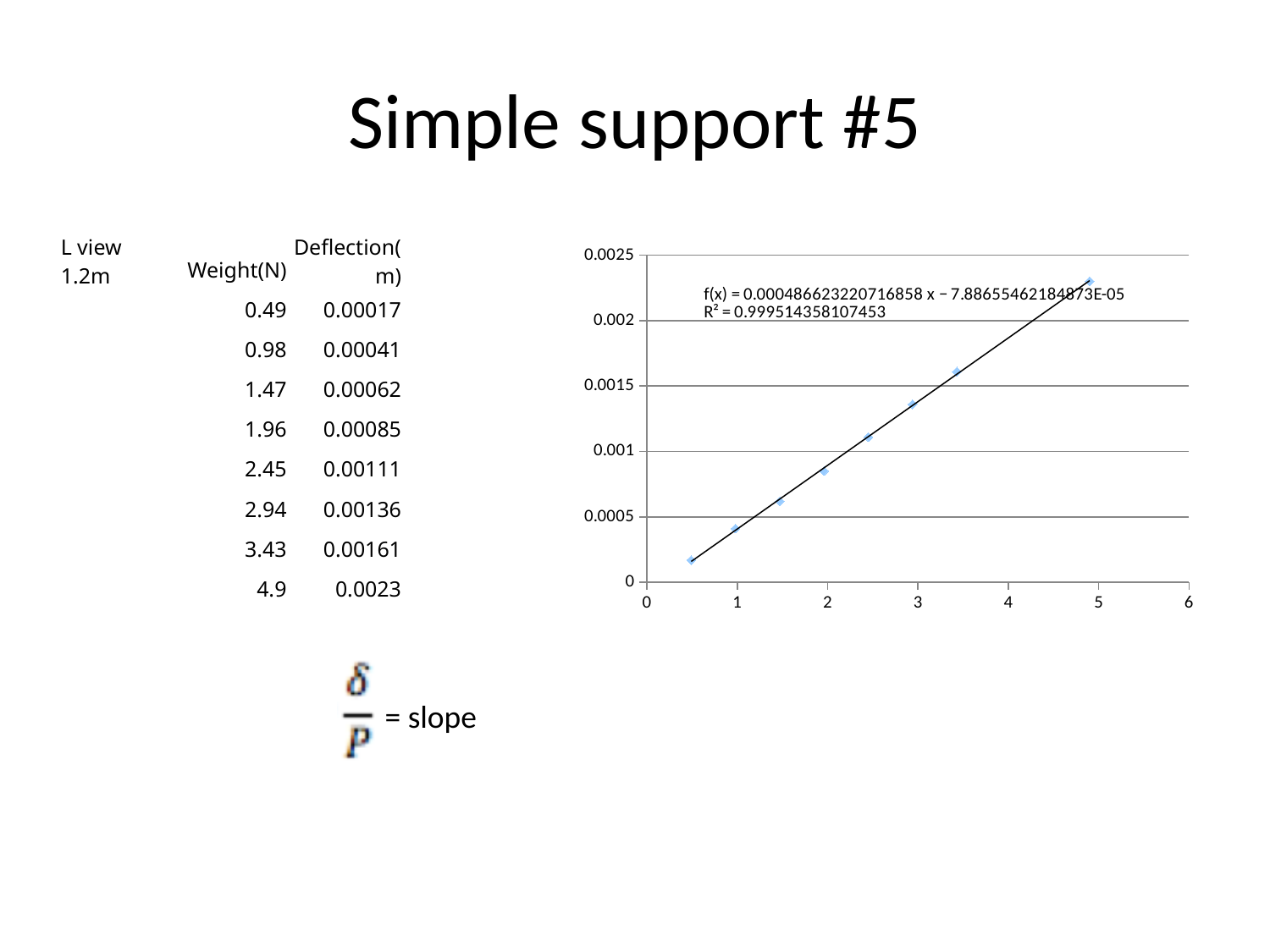
Is the plotted value at x = 3.43 greater or less than 0.0015? greater Which is larger, the plotted value at x = 1.96 or at x = 2.45? x = 2.45 What is the highest value shown on the chart's y axis? 0.0025 Do the plotted values rise or fall as the x value increases? rise Is the plotted value at x = 0.49 greater or less than 0.0005? less Is the plotted value at x = 4.9 greater or less than 0.002? greater Which x value has the highest plotted point? 4.9 What R² value is shown on the chart's trendline label? 0.999514358107453 How many data points are plotted on the chart? 8 Which x value has the lowest plotted point? 0.49 What kind of chart is shown on the slide? scatter chart